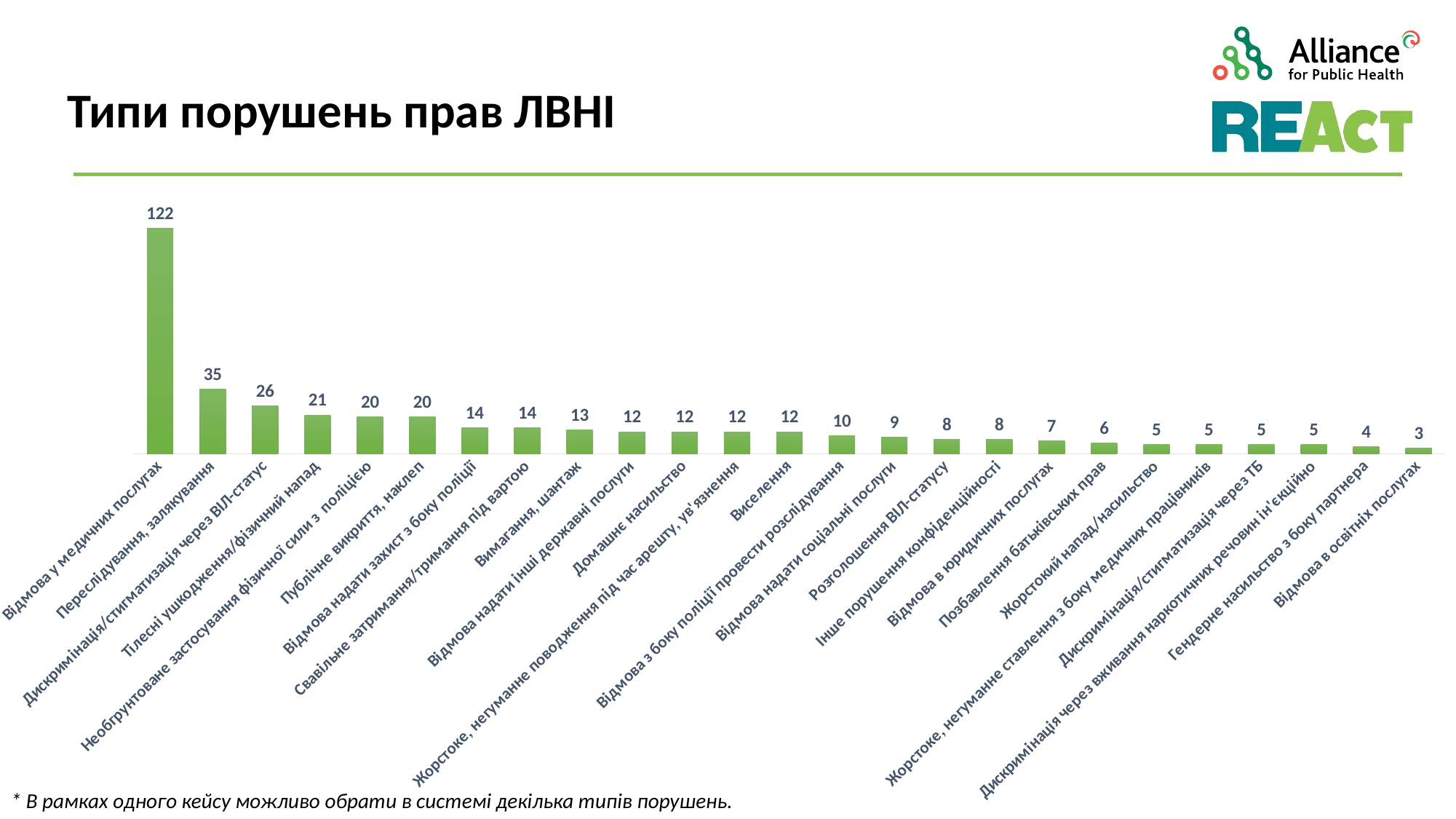
What is the difference between the values for "Відмова у медичних послугах" and "Переслідування, залякування"? 87 What is the value for "Позбавлення батьківських прав"? 6 What is the title of the slide? Типи порушень прав ЛВНІ Which category has the highest value? Відмова у медичних послугах What is the value for "Відмова у медичних послугах"? 122 Which category has the lowest value? Відмова в освітніх послугах How many categories are shown in the chart? 25 What kind of chart is shown on the slide? Bar chart What is the difference between the values for "Дискримінація/стигматизація через ВІЛ-статус" and "Тілесні ушкодження/фізичний напад"? 5 Which is larger: the value for "Вимагання, шантаж" or the value for "Розголошення ВІЛ-статусу"? Вимагання, шантаж What is the value for "Домашнє насильство"? 12 What is the value for "Переслідування, залякування"? 35